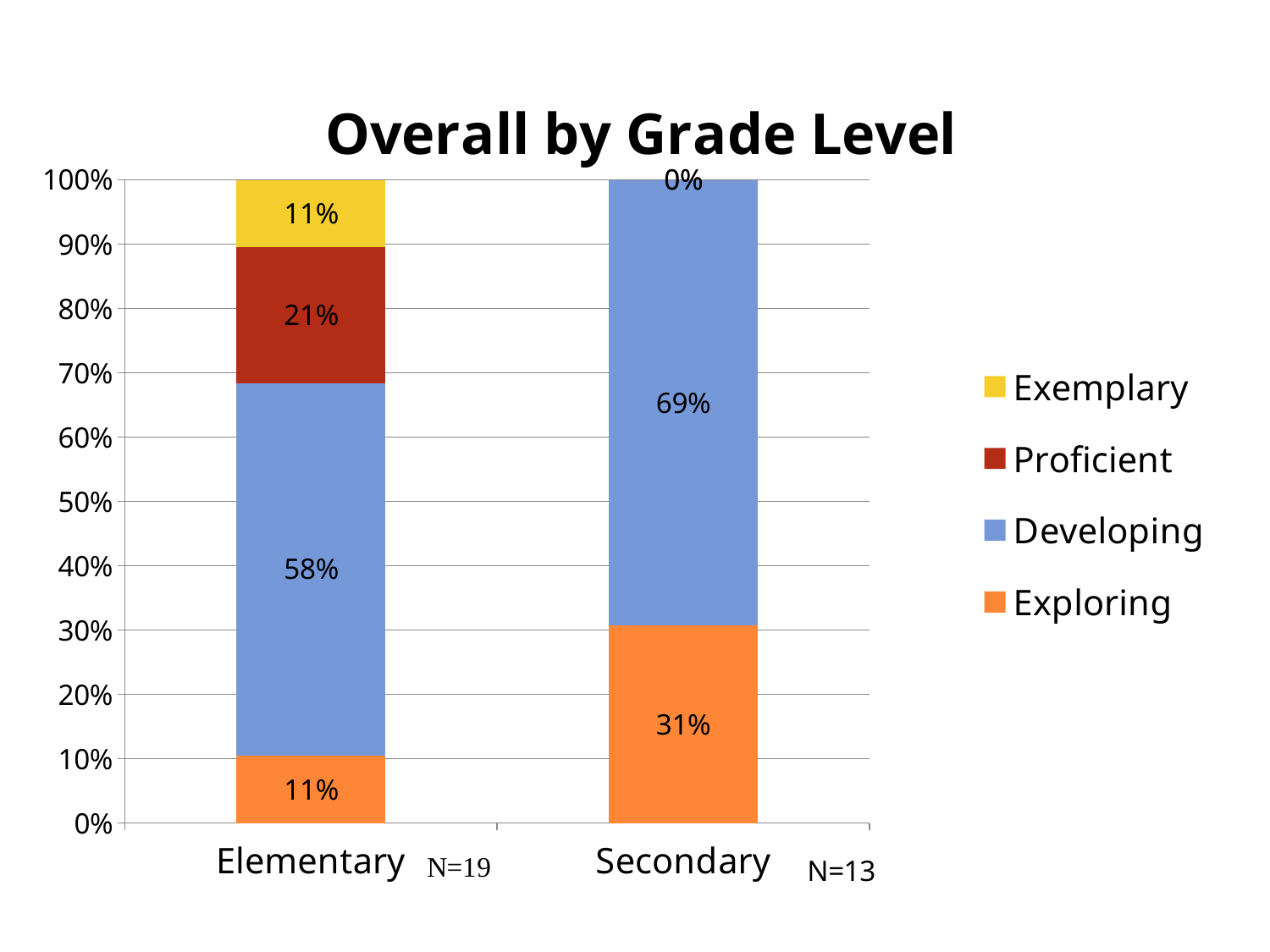
Which grade level has the higher Developing percentage? Secondary What is the Developing percentage for Elementary? 58% Which grade level has the higher Exploring percentage? Secondary What is the difference between the Developing percentages for Secondary and Elementary? 11% What is the Developing percentage for Secondary? 69% How many grade level categories are shown on the x axis? 2 What is the Proficient percentage for Elementary? 21% What is the difference between the Exploring percentages for Secondary and Elementary? 20% How many series does the legend list? 4 What is the Exploring percentage for Secondary? 31% What is the Exemplary percentage for Elementary? 11% What is the title of the chart? Overall by Grade Level